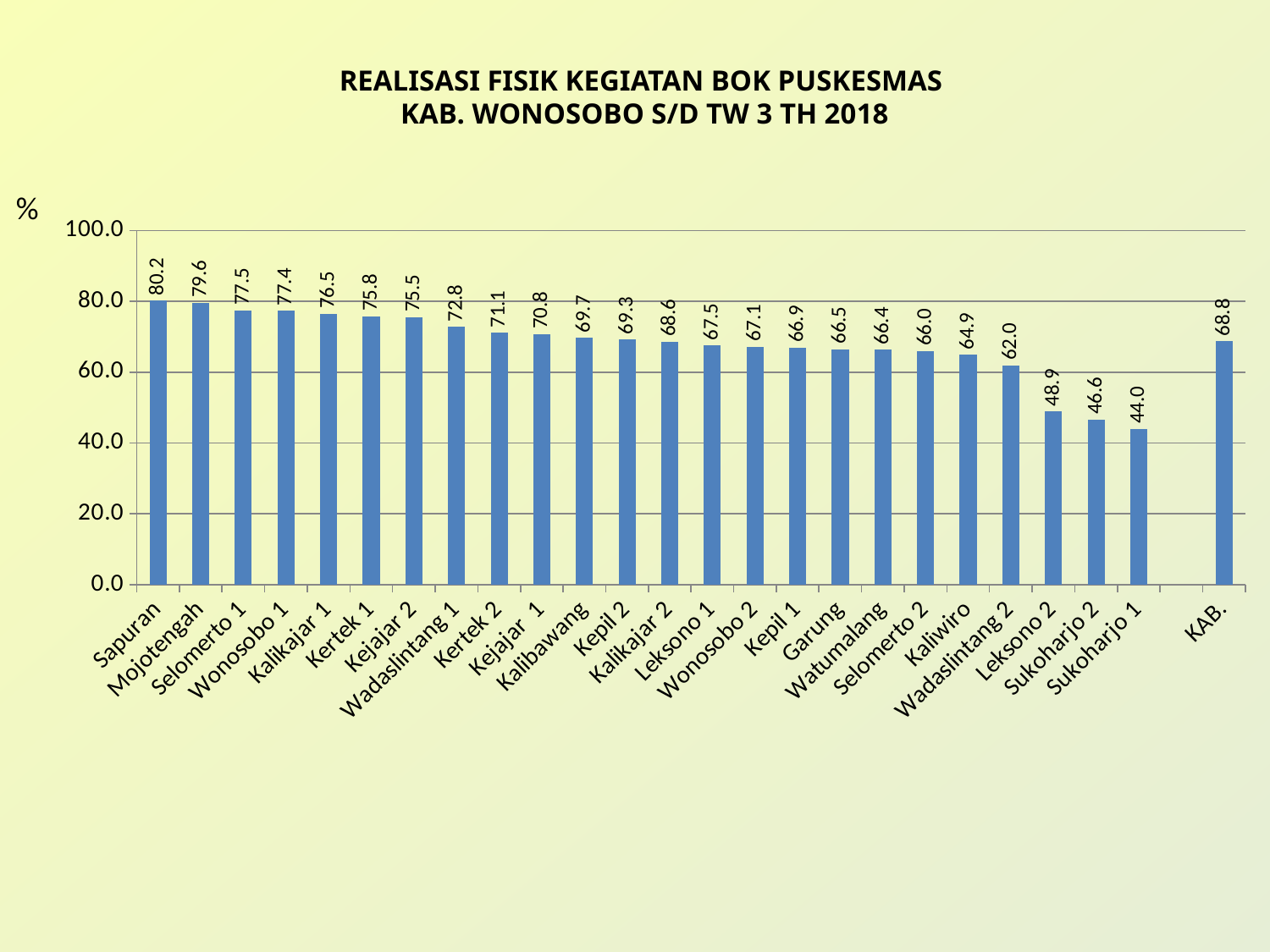
What kind of chart is shown on the slide? Bar chart Which is larger, the value for Leksono 2 or the value for Sukoharjo 2? Leksono 2 Which category has the lowest value? Sukoharjo 1 What is the value for KAB.? 68.8 What is the difference between the values for Sapuran and Sukoharjo 1? 36.2 Which category has the highest value? Sapuran What is the value for Sapuran? 80.2 What unit is shown on the vertical axis label? % Is the value for Kertek 2 greater or less than 60.0? greater How many bars are plotted in the chart? 25 What is the value for Kaliwiro? 64.9 What is the value for Wadaslintang 2? 62.0